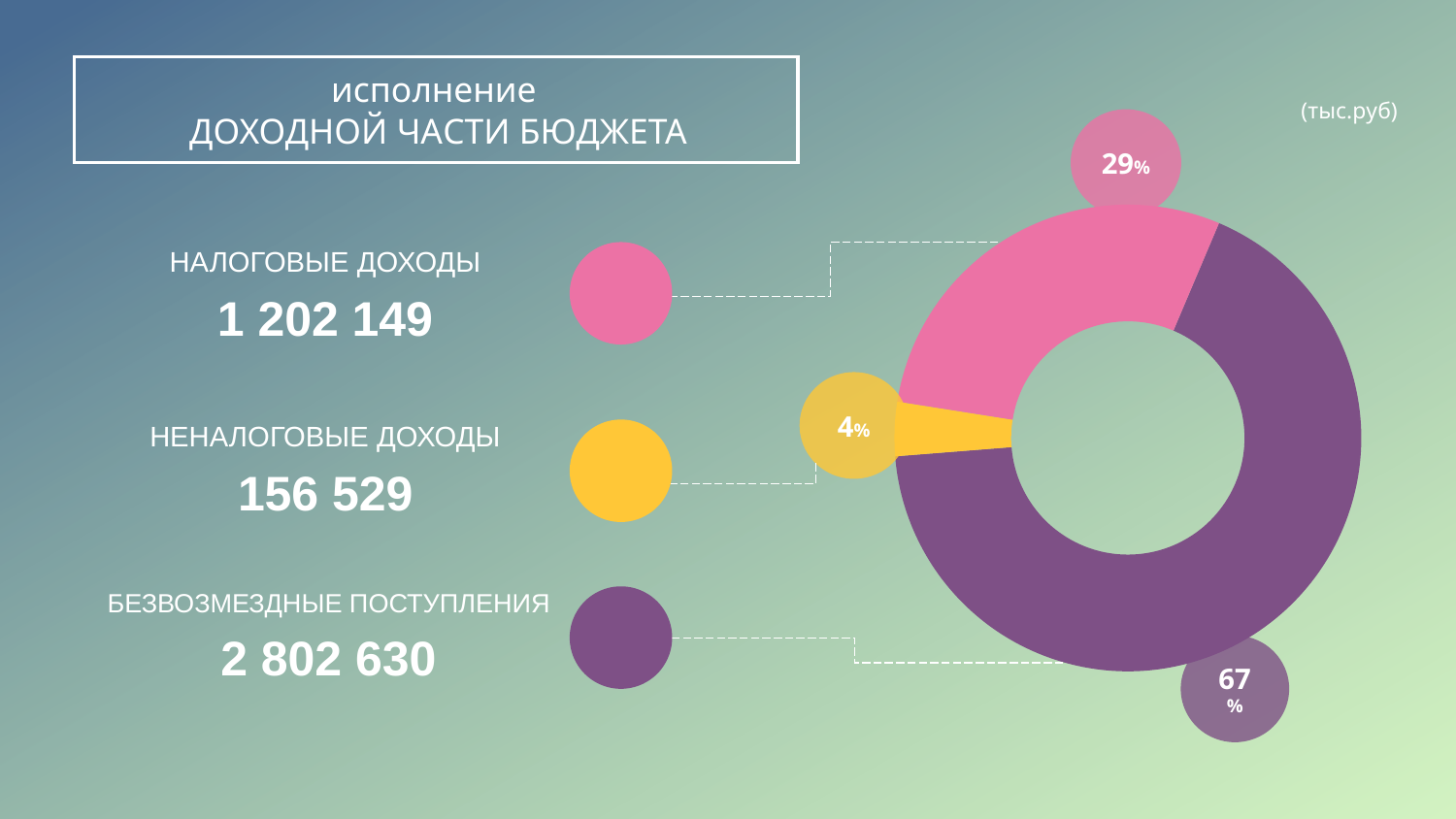
What share of the donut chart does БЕЗВОЗМЕЗДНЫЕ ПОСТУПЛЕНИЯ take? 67% Which category has the largest value? БЕЗВОЗМЕЗДНЫЕ ПОСТУПЛЕНИЯ What is the value for НЕНАЛОГОВЫЕ ДОХОДЫ? 156 529 What kind of chart is shown on the slide? Donut (pie) chart What is the difference between БЕЗВОЗМЕЗДНЫЕ ПОСТУПЛЕНИЯ and НАЛОГОВЫЕ ДОХОДЫ? 1 600 481 What unit is indicated for the values on the slide? тыс.руб Which category has the smallest value? НЕНАЛОГОВЫЕ ДОХОДЫ What share of the donut chart does НАЛОГОВЫЕ ДОХОДЫ take? 29% What share of the donut chart does НЕНАЛОГОВЫЕ ДОХОДЫ take? 4% What is the value for НАЛОГОВЫЕ ДОХОДЫ? 1 202 149 How many categories does the donut chart show? 3 What is the value for БЕЗВОЗМЕЗДНЫЕ ПОСТУПЛЕНИЯ? 2 802 630